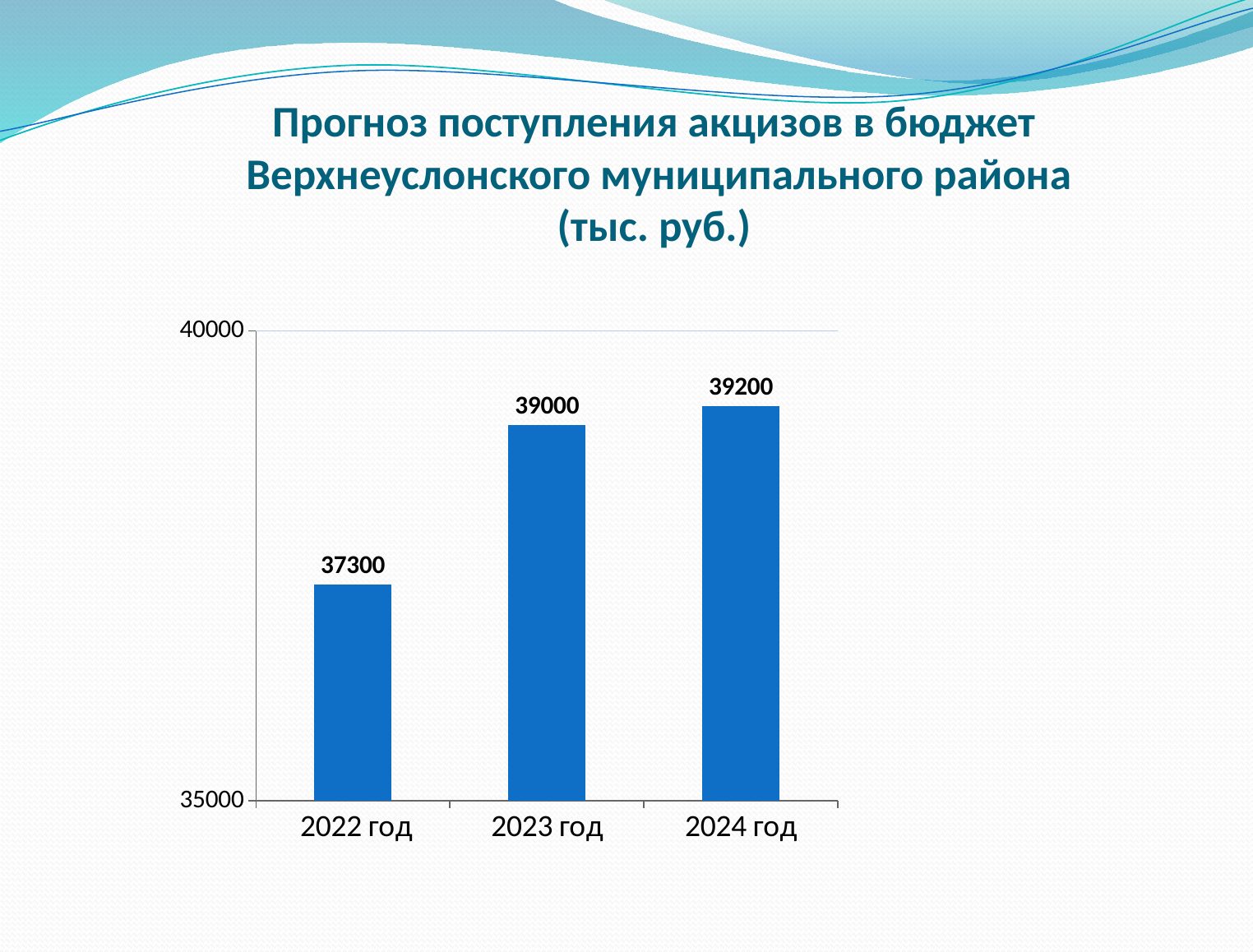
What is the forecast value for 2024 год? 39200 What is the forecast value for 2022 год? 37300 What kind of chart is shown on the slide? Bar chart Which year has the highest forecast value? 2024 год What is the difference between the values for 2023 год and 2022 год? 1700 What unit is given in the chart title? тыс. руб. Do the values rise or fall from 2022 год to 2024 год? Rise Which year has the lowest forecast value? 2022 год What is the difference between the values for 2024 год and 2023 год? 200 Which is larger, the value for 2022 год or the value for 2023 год? 2023 год What is the forecast value for 2023 год? 39000 How many years are shown on the chart? 3